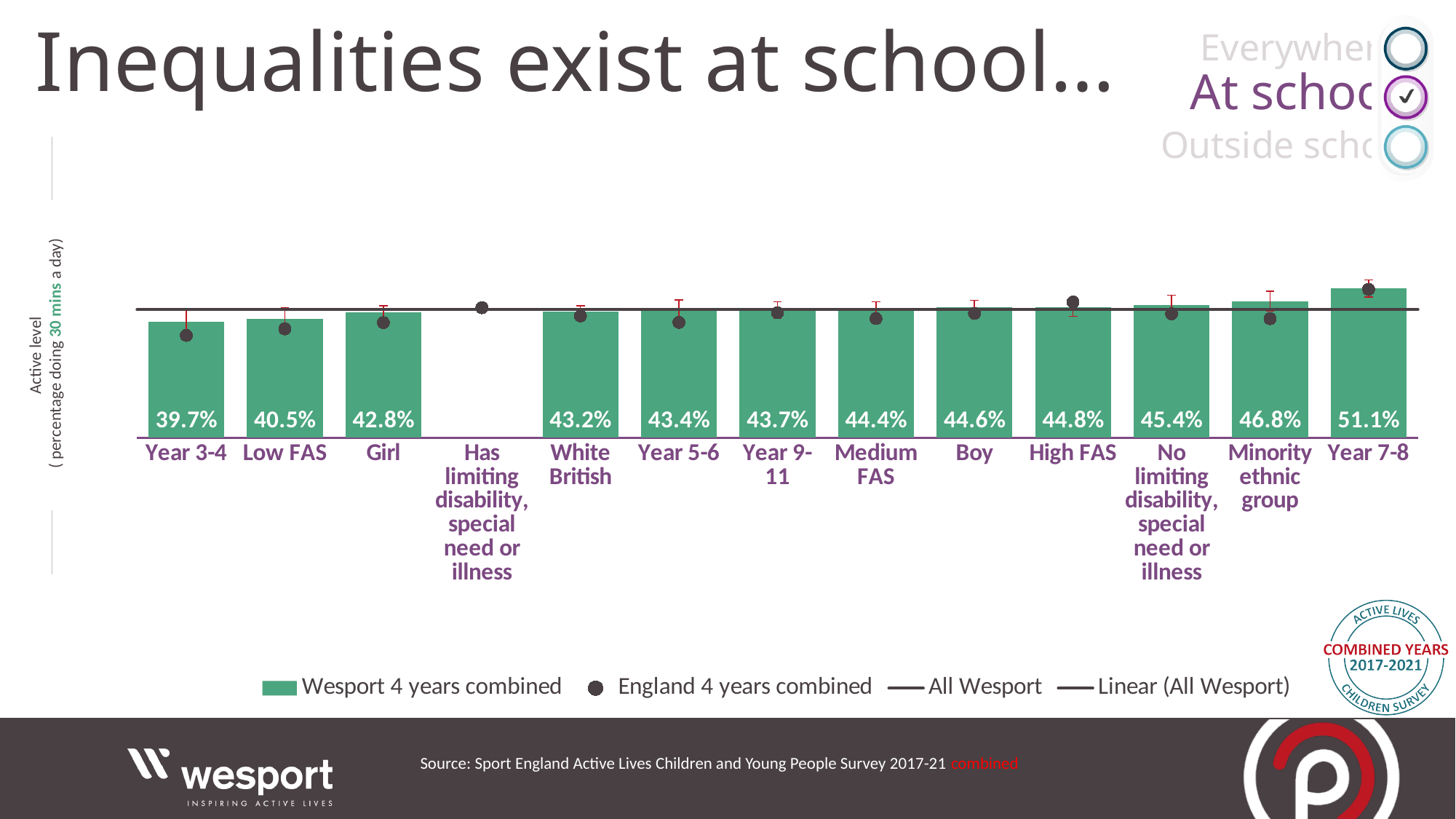
What is the Wesport 4 years combined value for Minority ethnic group? 46.8% Which category has the lowest Wesport 4 years combined value? Year 3-4 What is the difference between the Wesport values for Boy and Girl? 1.8% Do the Wesport bar values rise or fall from left to right along the x axis? Rise What is the Wesport 4 years combined value for High FAS? 44.8% What is the Wesport 4 years combined value for Year 3-4? 39.7% How many entries does the legend list? 4 What is the difference between the Wesport values for Year 7-8 and Year 3-4? 11.4% What kind of chart is shown on the slide? Combination bar and line chart Which has a larger Wesport value, Low FAS or High FAS? High FAS How many categories are shown on the x axis? 13 Which category has the highest Wesport 4 years combined value? Year 7-8